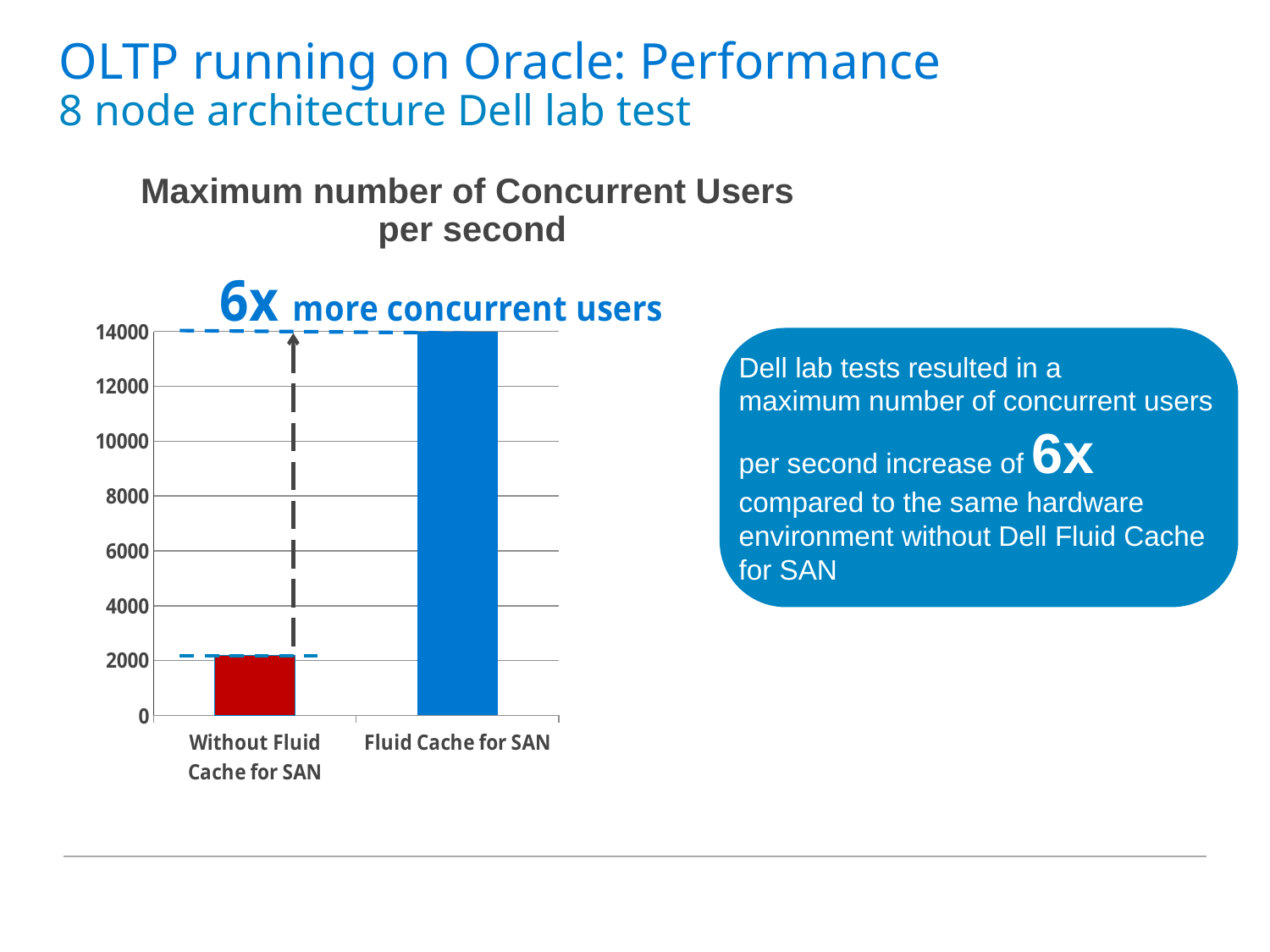
Which is larger: the value for Without Fluid Cache for SAN or the value for Fluid Cache for SAN? Fluid Cache for SAN Is the value for Without Fluid Cache for SAN greater or less than 4000? less Which category has the highest value in the chart? Fluid Cache for SAN What is the title of the chart? Maximum number of Concurrent Users per second What colour is the bar for Without Fluid Cache for SAN? red Do the values rise or fall from left to right across the categories? rise What is the highest value shown on the vertical axis of the chart? 14000 Which category has the lowest value in the chart? Without Fluid Cache for SAN How many categories are plotted in the chart? 2 What kind of chart is shown on the slide? bar chart Is the value for Fluid Cache for SAN greater or less than 12000? greater